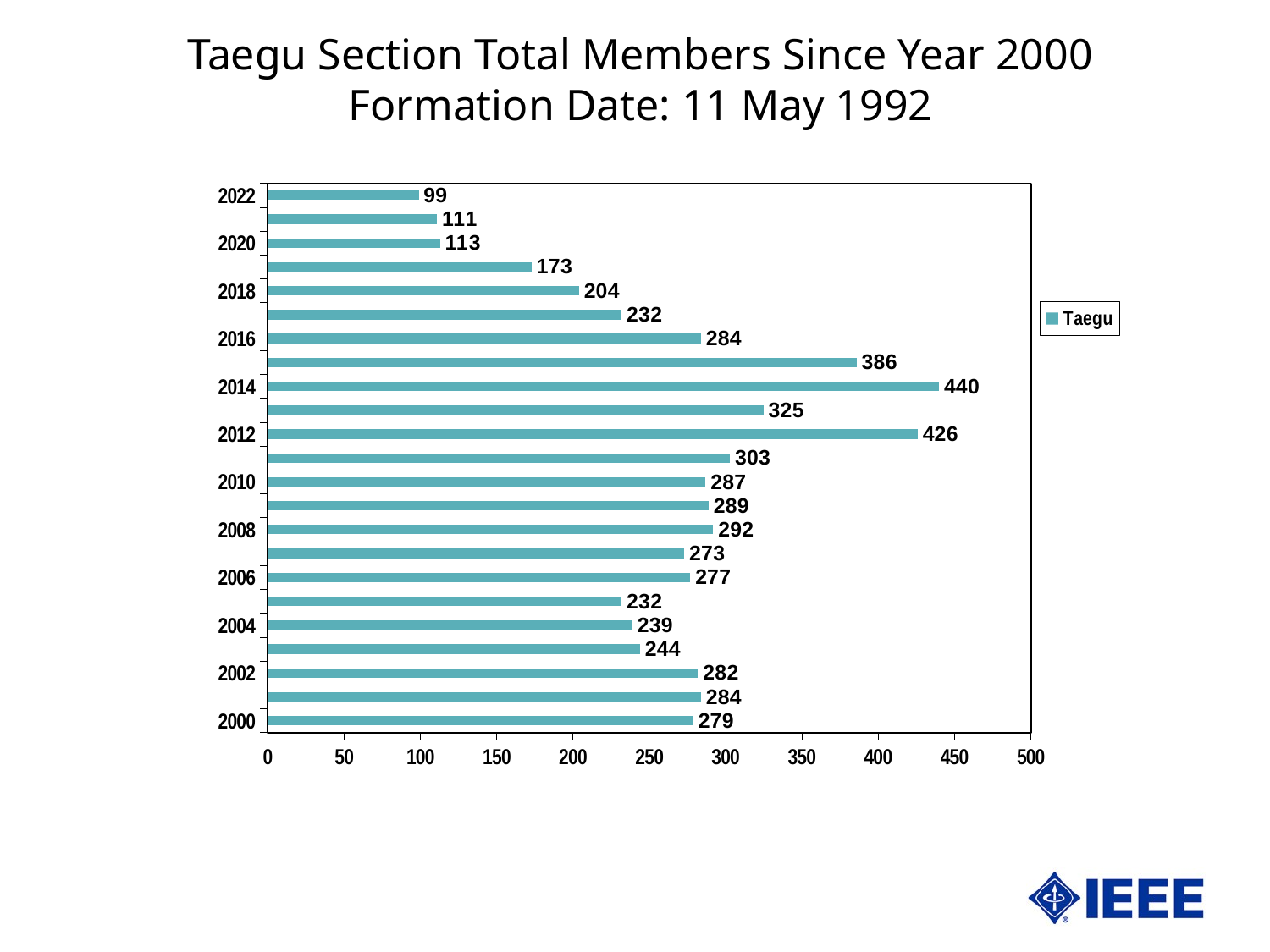
What is the difference between the values for 2014 and 2012? 14 What is the value for 2014? 440 What series name does the legend show? Taegu What is the value for 2012? 426 What is the value for 2000? 279 What kind of chart is shown on the slide? bar chart What is the difference between the values for 2016 and 2020? 171 Which year has the lowest value? 2022 How many bars are plotted in the chart? 23 What is the value for 2022? 99 Which year has the highest value? 2014 Which is larger, the value for 2008 or the value for 2018? 2008